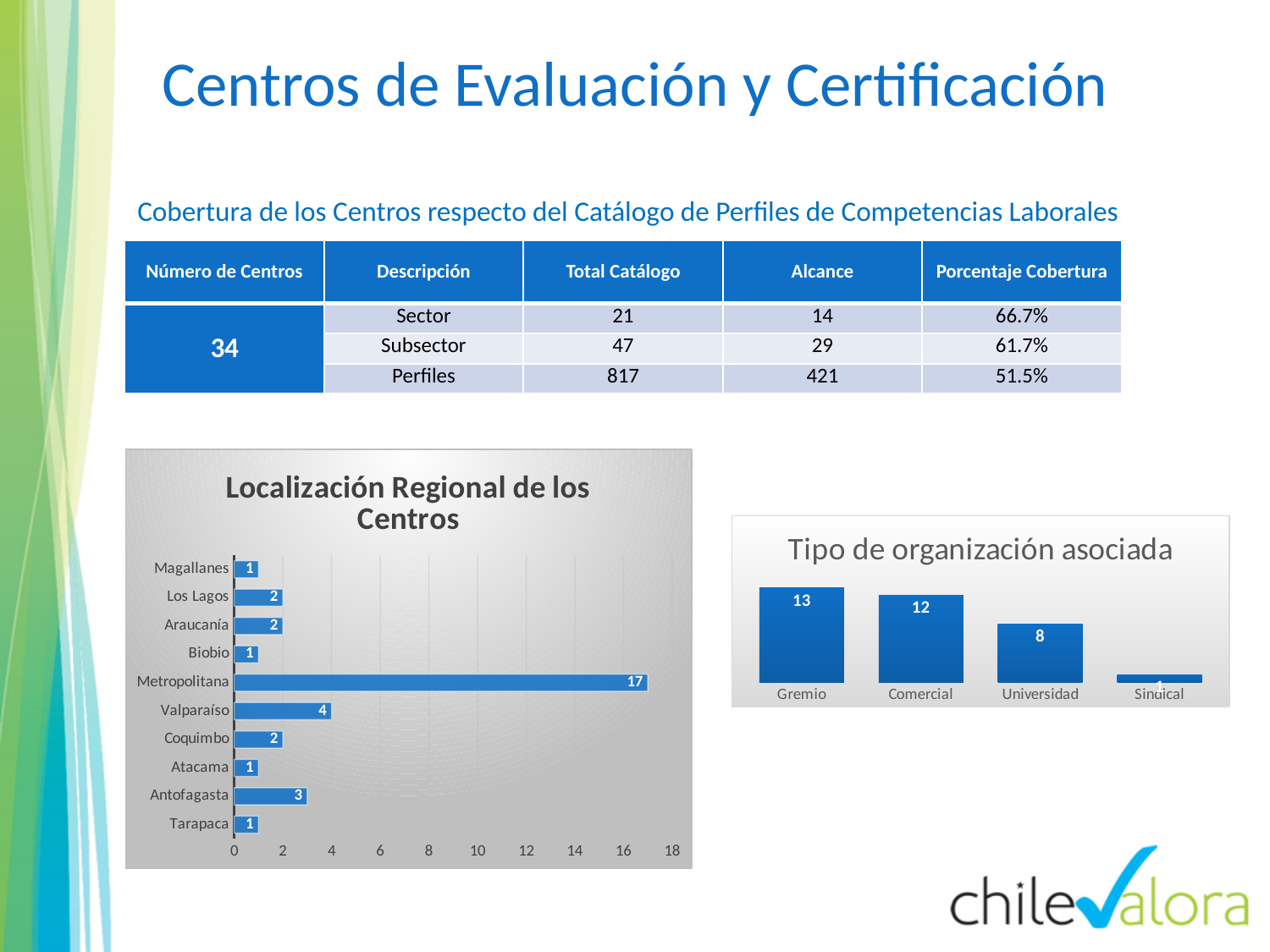
In the 'Localización Regional de los Centros' chart, what is the value for Metropolitana? 17 In the 'Localización Regional de los Centros' chart, how many regions are shown? 10 What kind of chart is 'Localización Regional de los Centros'? Bar chart In the 'Localización Regional de los Centros' chart, what is the value for Valparaíso? 4 In the 'Tipo de organización asociada' chart, what is the value for Gremio? 13 In the 'Tipo de organización asociada' chart, what is the difference between Gremio and Universidad? 5 In the 'Tipo de organización asociada' chart, which category has the lowest value? Sindical In the 'Localización Regional de los Centros' chart, what is the difference between Metropolitana and Valparaíso? 13 In the 'Localización Regional de los Centros' chart, what is the value for Antofagasta? 3 In the 'Localización Regional de los Centros' chart, which region has the highest value? Metropolitana In the 'Tipo de organización asociada' chart, what is the value for Universidad? 8 In the 'Localización Regional de los Centros' chart, which is larger, Antofagasta or Coquimbo? Antofagasta